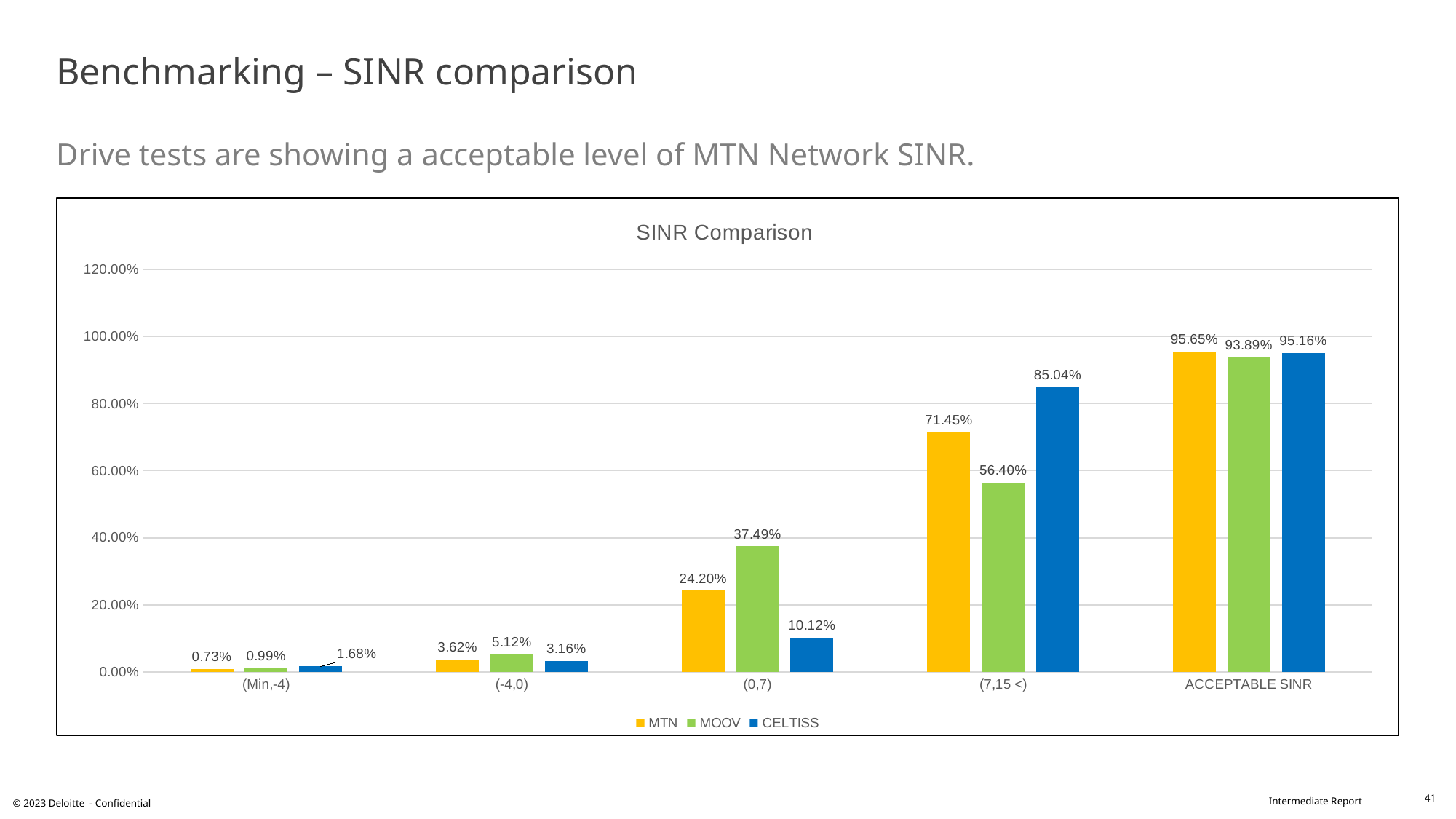
How many series does the legend list? 3 What is the MOOV value for the ACCEPTABLE SINR category? 93.89% Which is larger in the (-4,0) category, the MTN value or the MOOV value? MOOV Which series has the highest value in the (7,15 <) category? CELTISS What is the CELTISS value for the (7,15 <) category? 85.04% What is the title of the chart? SINR Comparison What is the difference between the MOOV and CELTISS values in the (0,7) category? 27.37% Which series has the lowest value in the (Min,-4) category? MTN What kind of chart is shown on the slide? Bar chart What is the MTN value for the (0,7) category? 24.20% Is the MTN value for the (7,15 <) category greater or less than 60.00%? greater How many categories are shown on the x axis? 5